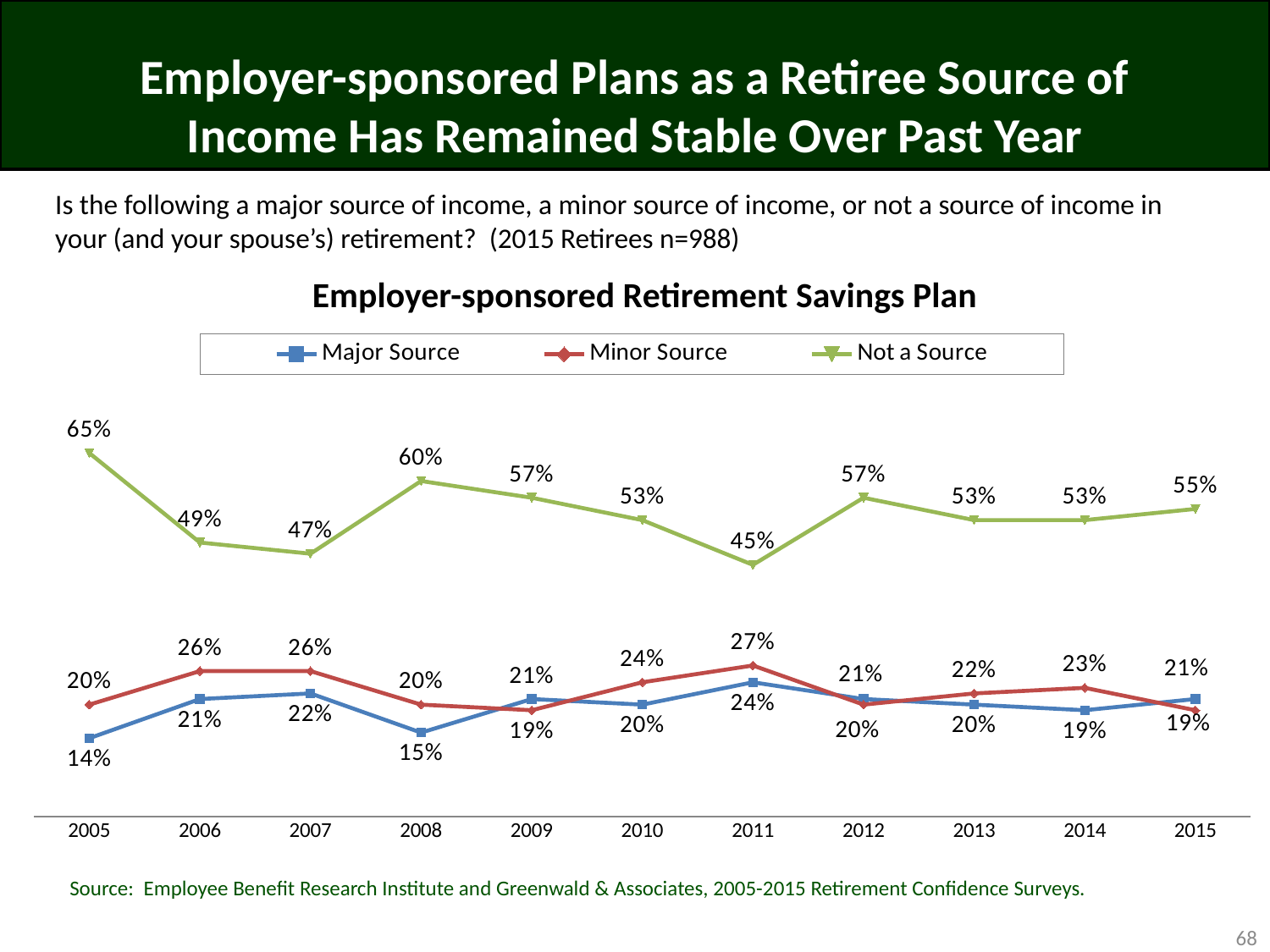
In which year is Major Source at its lowest? 2005 How many series does the legend list? 3 What is the title of the chart? Employer-sponsored Retirement Savings Plan What type of chart is shown on the slide? line chart Which is larger in 2006, Minor Source or Major Source? Minor Source What is the value for Not a Source in 2011? 45% How many years are plotted along the x axis? 11 What is the value for Minor Source in 2011? 27% What is the difference between Not a Source in 2008 and in 2011? 15% What is the value for Major Source in 2008? 15% In which year is Not a Source at its highest? 2005 What is the value for Not a Source in 2005? 65%